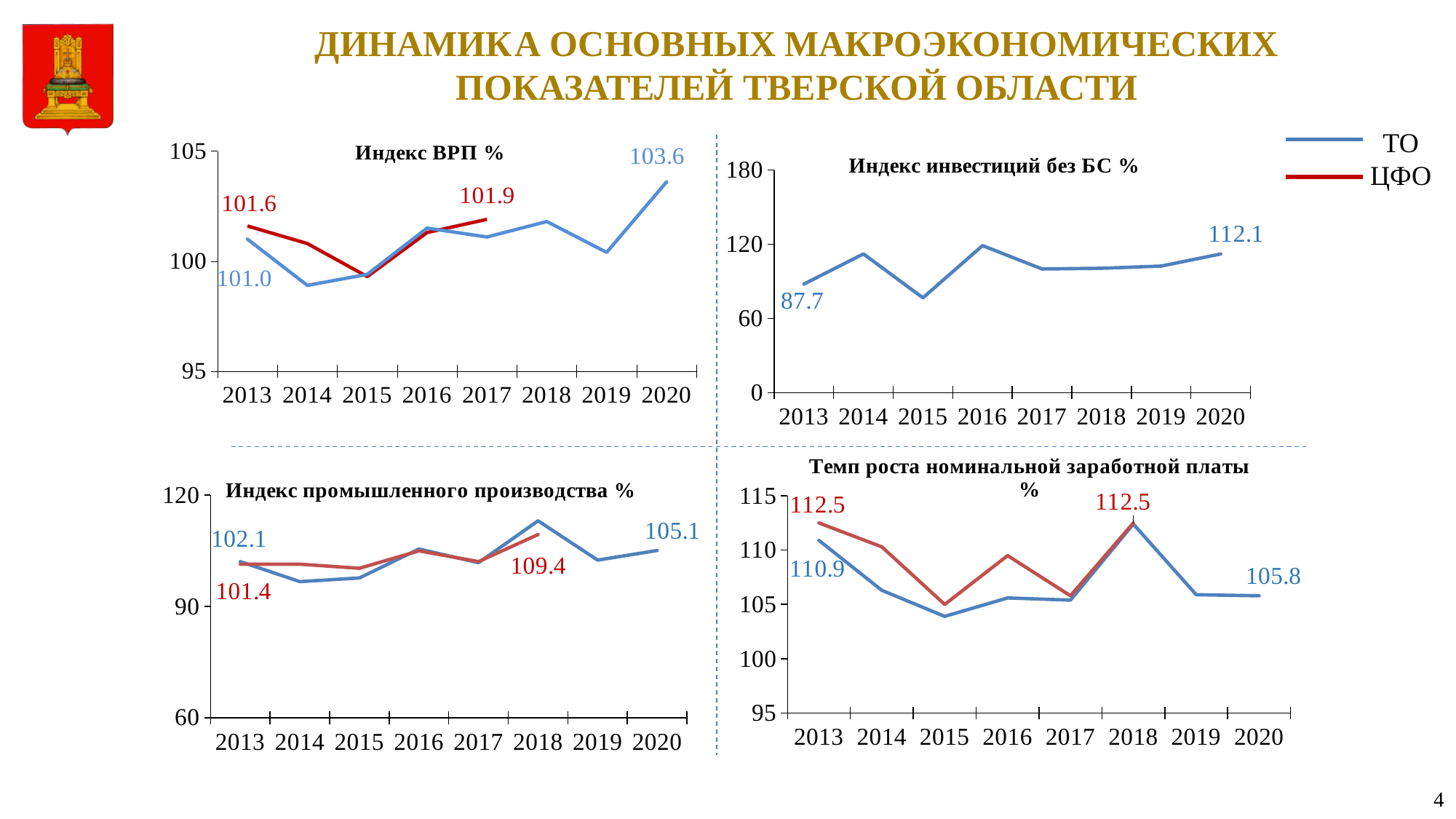
What kind of chart is 'Индекс ВРП %'? line chart In the chart titled 'Индекс ВРП %', what is the difference between the ТО value in 2020 and the ТО value in 2013? 2.6 In the chart titled 'Индекс инвестиций без БС %', what is the value in 2013? 87.7 In the chart titled 'Темп роста номинальной заработной платы %', which series has the higher value in 2013, ТО or ЦФО? ЦФО How many series does the legend at the top right of the slide list? 2 In the chart titled 'Индекс ВРП %', what is the value for ТО in 2020? 103.6 In the chart titled 'Индекс инвестиций без БС %', is the value for 2015 greater or less than 120? less In the chart titled 'Индекс промышленного производства %', what is the value for ЦФО in 2018? 109.4 In the chart titled 'Индекс инвестиций без БС %', in which year is the value lowest? 2015 In the chart titled 'Индекс ВРП %', what is the value for ЦФО in 2013? 101.6 In the chart titled 'Индекс инвестиций без БС %', what is the difference between the 2020 value and the 2013 value? 24.4 In the chart titled 'Темп роста номинальной заработной платы %', what is the value for ТО in 2020? 105.8